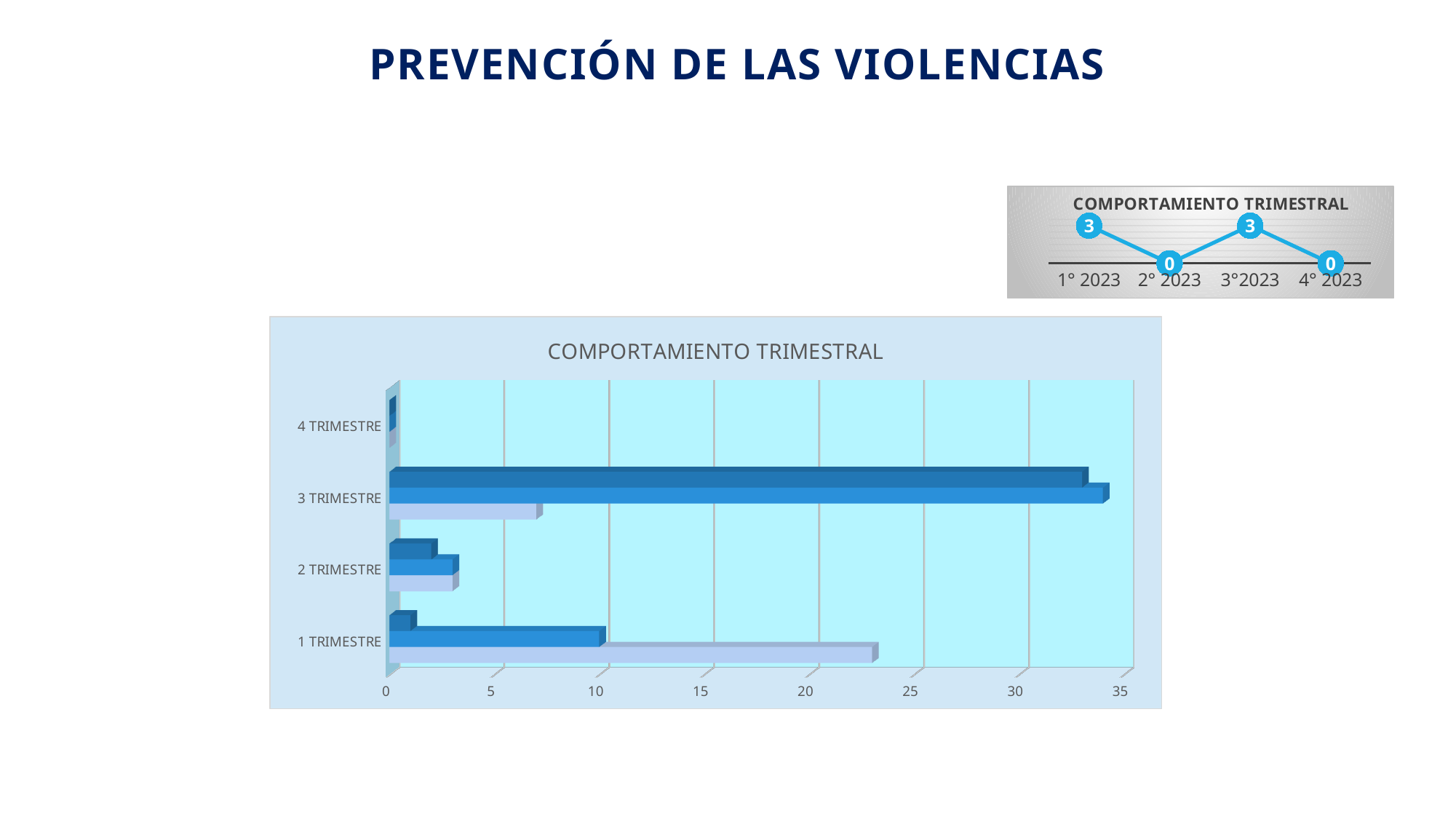
In the large bar chart, how many categories are shown on the vertical axis? 4 In the line chart at the top right, which is larger, the value for 3°2023 or the value for 4° 2023? 3°2023 In the line chart at the top right, what is the value for 1° 2023? 3 What kind of chart is the large chart in the lower part of the slide? Bar chart In the large bar chart, which category has the longest bar? 3 TRIMESTRE In the line chart at the top right, how many data points are plotted? 4 In the line chart at the top right, what is the difference between the values for 1° 2023 and 2° 2023? 3 What is the title of the large bar chart? COMPORTAMIENTO TRIMESTRAL In the large bar chart, is the longest bar for 3 TRIMESTRE greater or less than 30? greater In the line chart at the top right, what is the value for 3°2023? 3 In the large bar chart, is the light-coloured bar for 1 TRIMESTRE greater or less than 20? greater In the line chart at the top right, what is the value for 2° 2023? 0